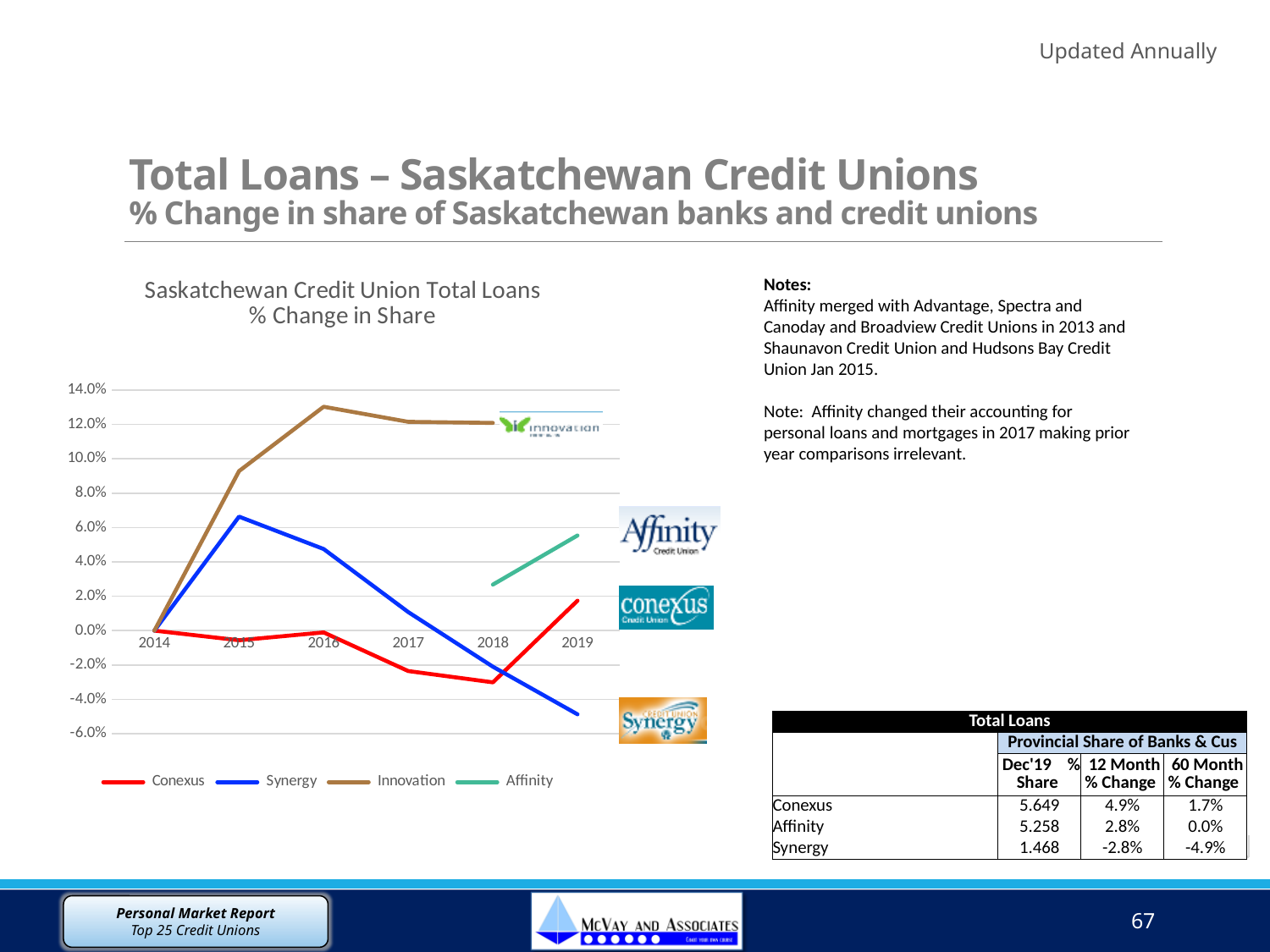
What type of chart is shown on the slide? Line chart How many series does the chart legend list? 4 How many years are shown along the x axis of the chart? 6 Is the value for Affinity in 2019 greater or less than 4.0%? greater What is the title of the chart? Saskatchewan Credit Union Total Loans % Change in Share Is the value for Conexus in 2018 greater or less than -2.0%? less Which credit union has the highest % change in share in 2016? Innovation Which is larger in 2017, the value for Innovation or the value for Conexus? Innovation Is the value for Synergy in 2019 greater or less than -4.0%? less Does the Synergy line rise or fall from 2015 to 2019? Fall Which credit union has the lowest % change in share in 2019? Synergy